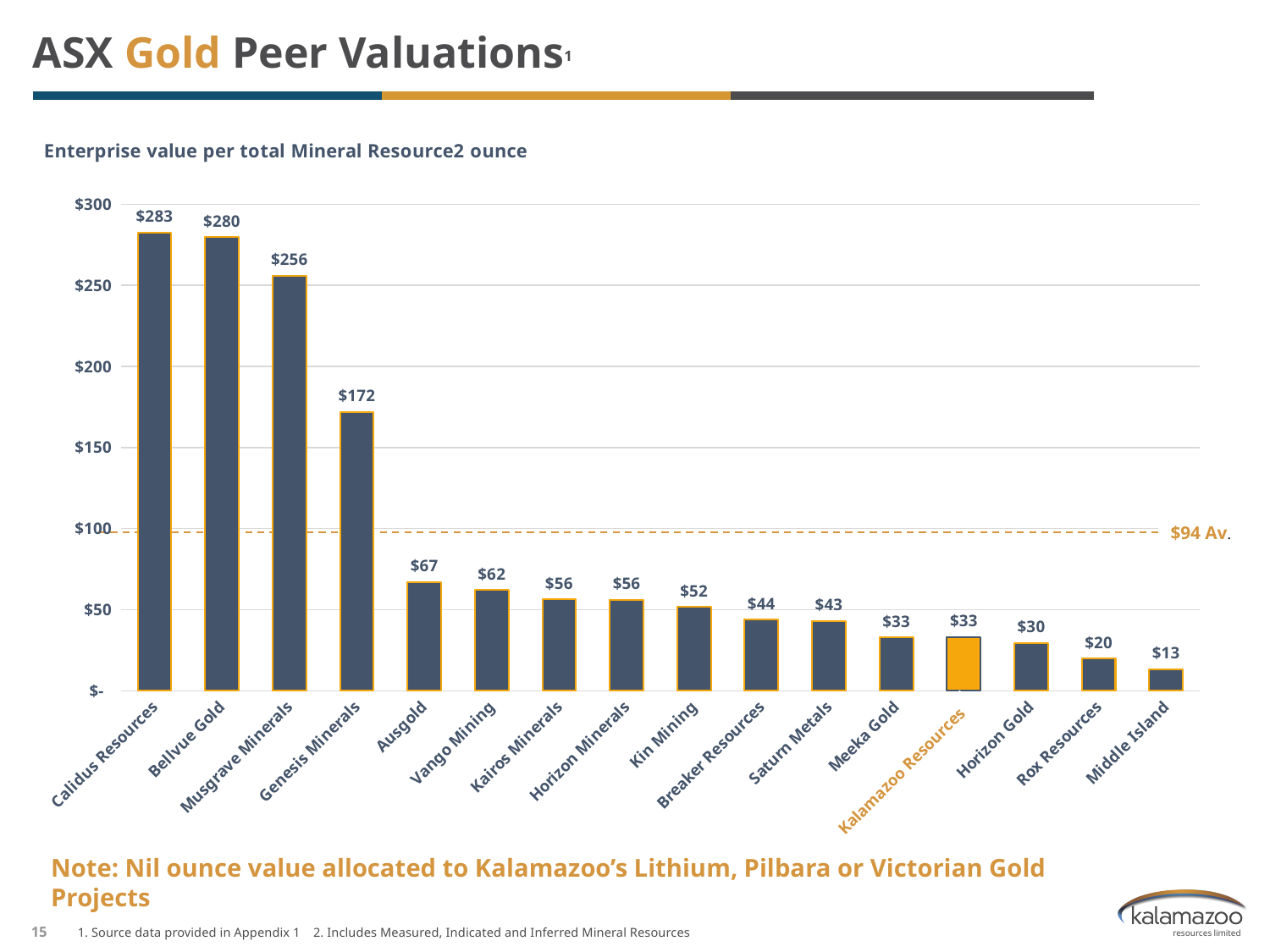
What is the enterprise value per total Mineral Resource ounce for Kalamazoo Resources? $33 How many companies are shown on the chart? 16 Which company has the lowest enterprise value per ounce? Middle Island Is the value for Genesis Minerals greater or less than $150? greater What is the difference between the values for Calidus Resources and Musgrave Minerals? $27 What is the value shown for Genesis Minerals? $172 Which is larger, the value for Ausgold or the value for Kin Mining? Ausgold What average value is marked by the dashed line on the chart? $94 Which company has the highest enterprise value per ounce? Calidus Resources What kind of chart is shown on the slide? Bar chart What is the value shown for Middle Island? $13 Do the values rise or fall moving from left to right along the x axis? Fall